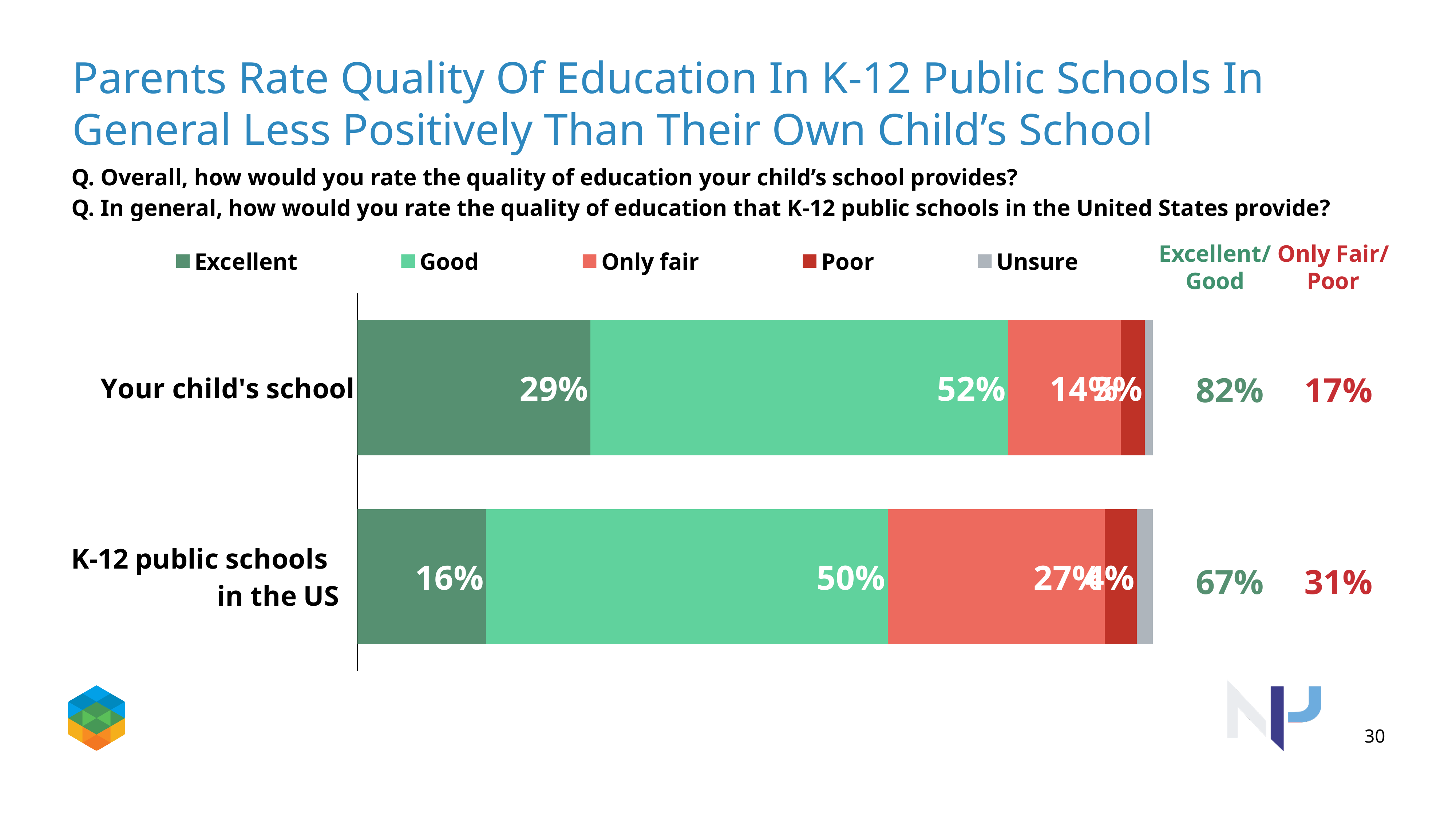
What is the combined Only Fair/Poor figure shown for K-12 public schools in the US? 31% What percentage of parents rate K-12 public schools in the US as Good? 50% Which category has the higher combined Excellent/Good rating? Your child's school How many categories (bars) are shown in the chart? 2 What percentage of parents rate their own child's school as Excellent? 29% What kind of chart is shown on the slide? Stacked bar chart How many series does the legend list? 5 What is the combined Excellent/Good figure shown for Your child's school? 82% How many percentage points higher is the Excellent rating for Your child's school than for K-12 public schools in the US? 13 percentage points What is the Only fair value for K-12 public schools in the US? 27% Which has the larger Only fair share: Your child's school or K-12 public schools in the US? K-12 public schools in the US What is the difference between the Good ratings for Your child's school and K-12 public schools in the US? 2 percentage points